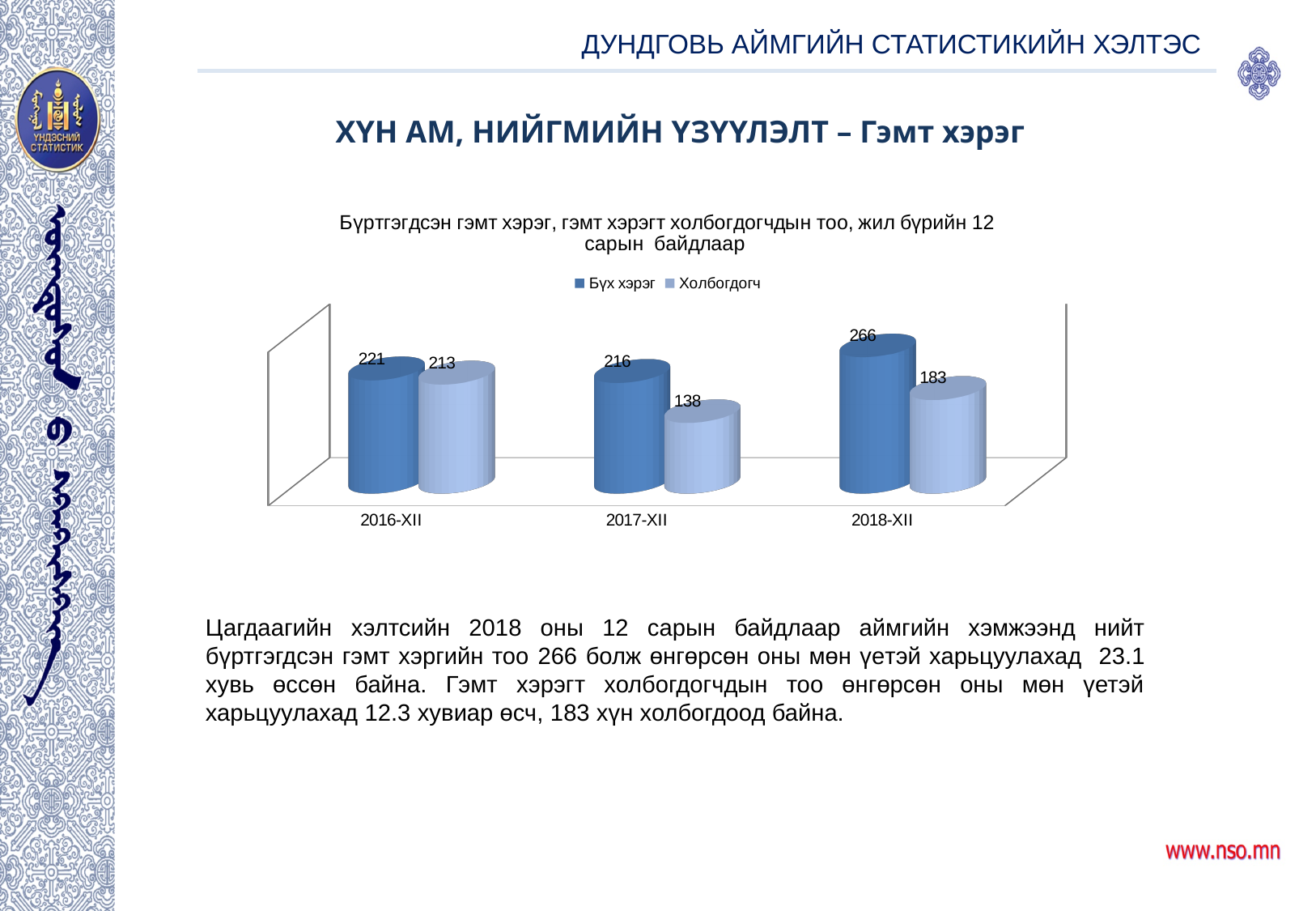
What is the value of Холбогдогч for 2016-XII? 213 Which period has the highest value for Бүх хэрэг? 2018-XII How many series does the legend list? 2 What is the value of Бүх хэрэг for 2018-XII? 266 How many periods are shown on the x axis? 3 What kind of chart is shown on the slide? Bar chart What is the value of Холбогдогч for 2017-XII? 138 Which is larger: Холбогдогч in 2016-XII or Холбогдогч in 2018-XII? 2016-XII Which period has the lowest value for Холбогдогч? 2017-XII Does the Бүх хэрэг series rise or fall from 2017-XII to 2018-XII? Rise What is the difference between Бүх хэрэг and Холбогдогч in 2017-XII? 78 By how much did Бүх хэрэг increase from 2017-XII to 2018-XII? 50